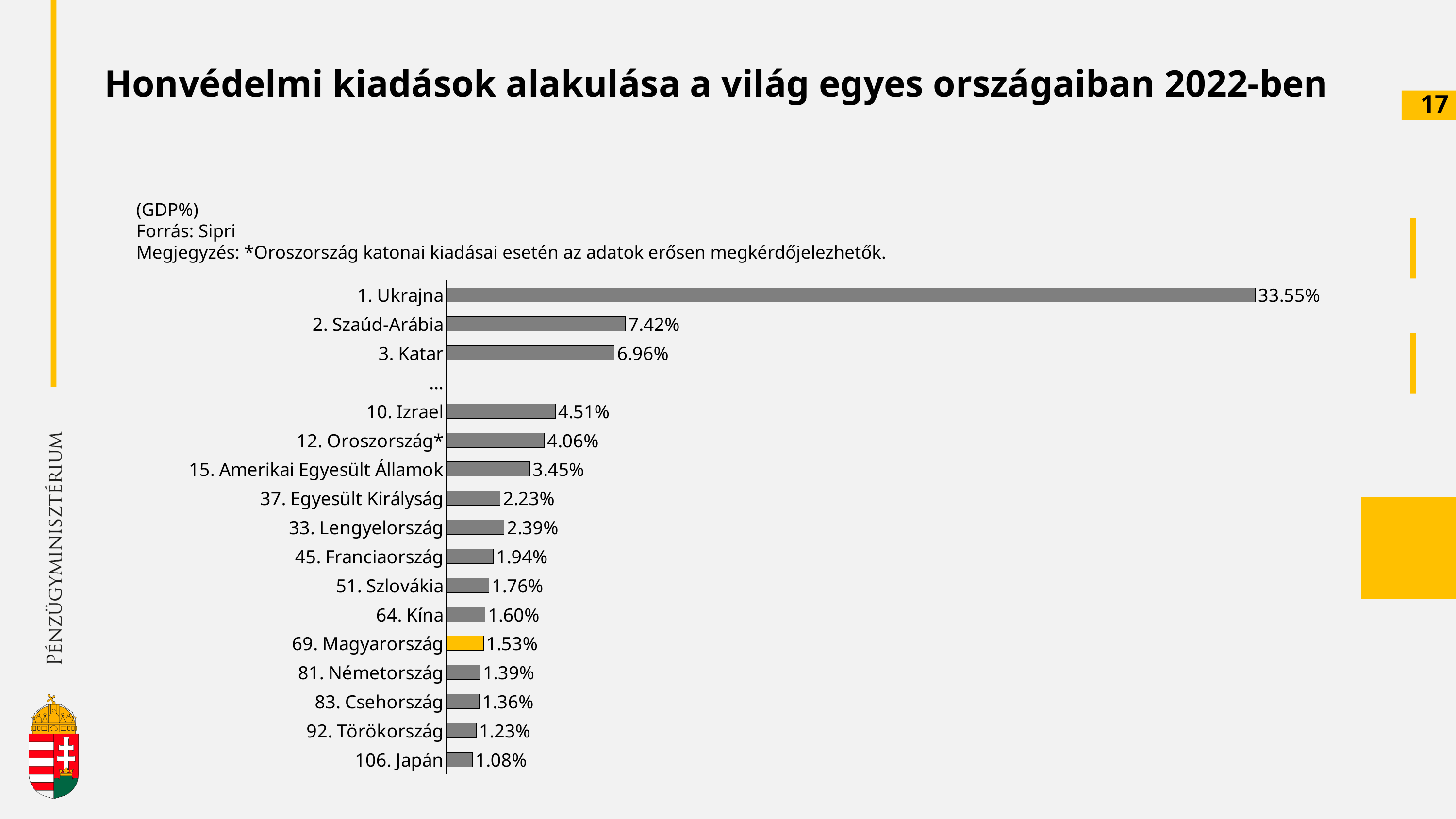
What is the difference between the values for 33. Lengyelország and 37. Egyesült Királyság? 0.16 percentage points How many countries have bars plotted on the chart? 16 Which country has the lowest value on the chart? 106. Japán Which has a larger value, 10. Izrael or 15. Amerikai Egyesült Államok? 10. Izrael What is the value shown for 69. Magyarország? 1.53% Which country's bar is highlighted in yellow instead of grey? 69. Magyarország What is the value shown for 12. Oroszország*? 4.06% Which country has the highest value on the chart? 1. Ukrajna What is the value shown for 1. Ukrajna? 33.55% What is the value shown for 106. Japán? 1.08% What kind of chart is shown on the slide? Bar chart What is the difference between the values for 1. Ukrajna and 2. Szaúd-Arábia? 26.13 percentage points